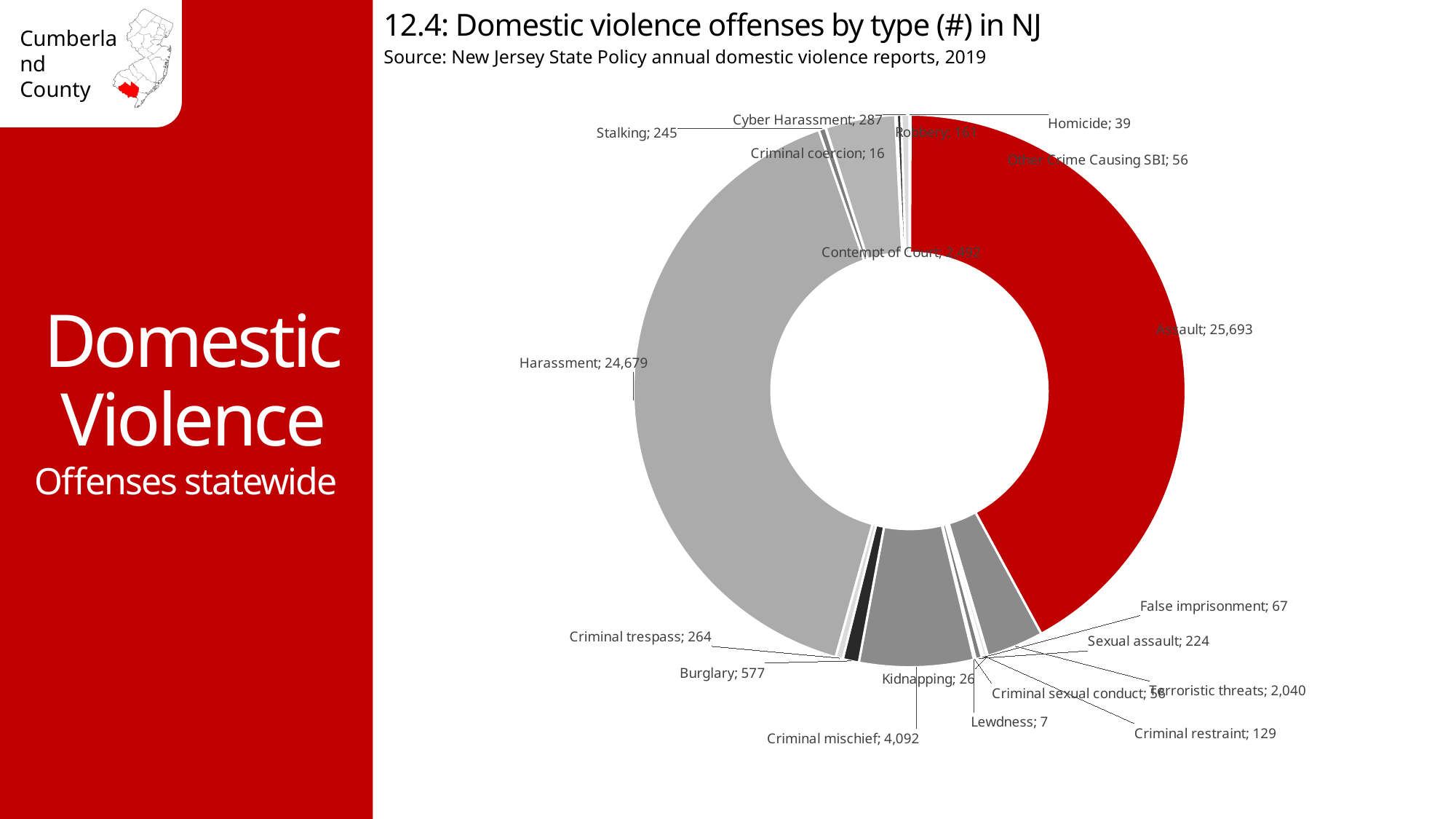
What is the difference between Burglary and Criminal trespass? 313 How many Homicide offenses are shown? 39 What value is shown for Criminal mischief? 4,092 Which offense type has the largest number of offenses? Assault Which is larger, Stalking or Cyber Harassment? Cyber Harassment What is the difference between the Assault and Harassment values? 1,014 What kind of chart is shown on the slide? doughnut chart How many Harassment offenses does the chart show? 24,679 What is the value for Terroristic threats? 2,040 Which offense type has the smallest number of offenses? Lewdness What is the number of Assault offenses shown on the chart? 25,693 Which is larger, Criminal mischief or Terroristic threats? Criminal mischief